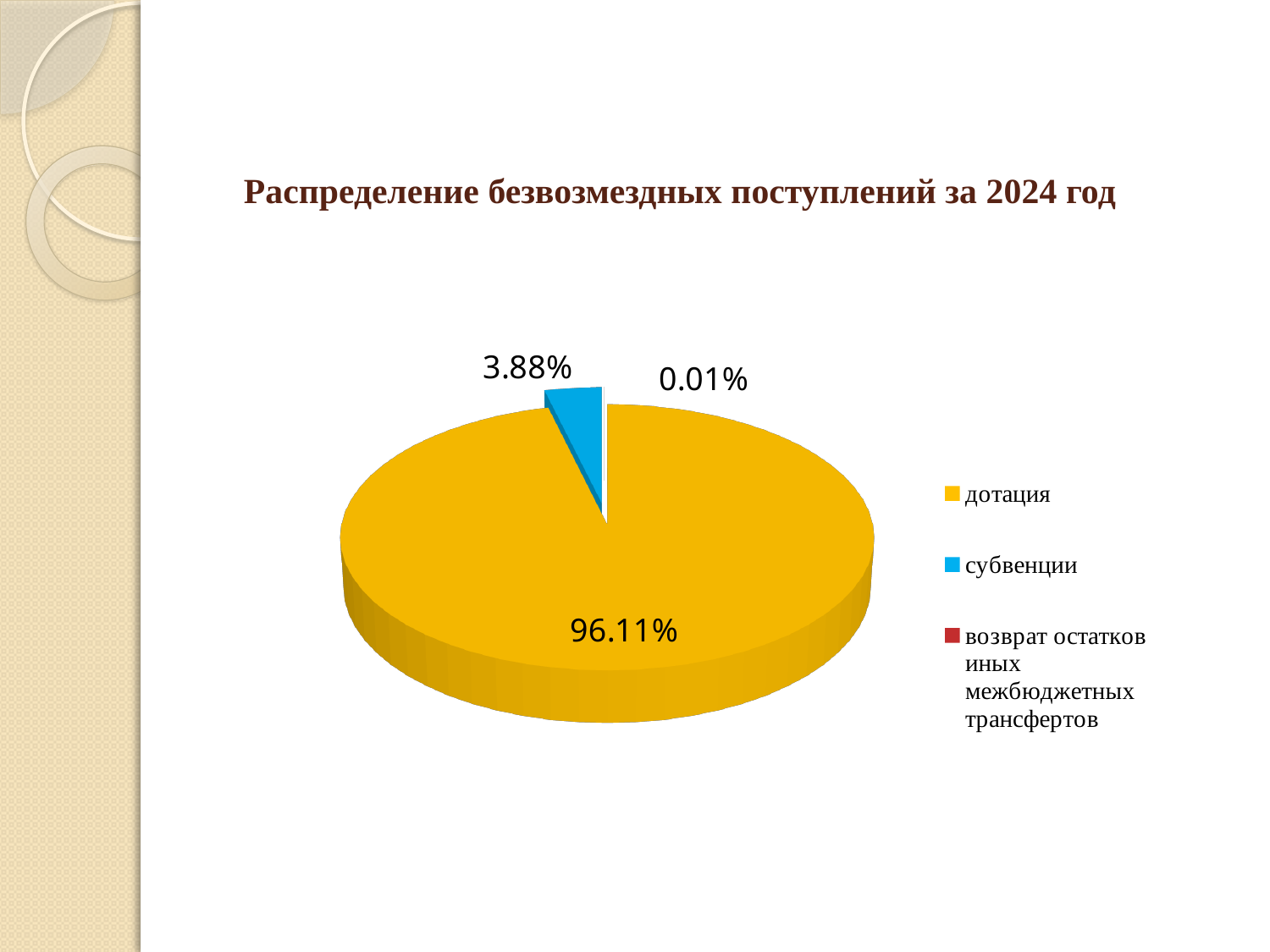
What is the difference between the shares of дотация and субвенции? 92.23% What share of the pie does возврат остатков иных межбюджетных трансфертов account for? 0.01% What is the title of the chart? Распределение безвозмездных поступлений за 2024 год Which category has the smallest share of the pie? возврат остатков иных межбюджетных трансфертов What share of the pie does субвенции account for? 3.88% What share of the pie does дотация account for? 96.11% How many series does the legend list? 3 What colour is the slice for субвенции? blue Which category has the largest share of the pie? дотация Which is larger, the share of субвенции or the share of возврат остатков иных межбюджетных трансфертов? субвенции How many slices does the pie chart have? 3 What kind of chart is shown on the slide? pie chart